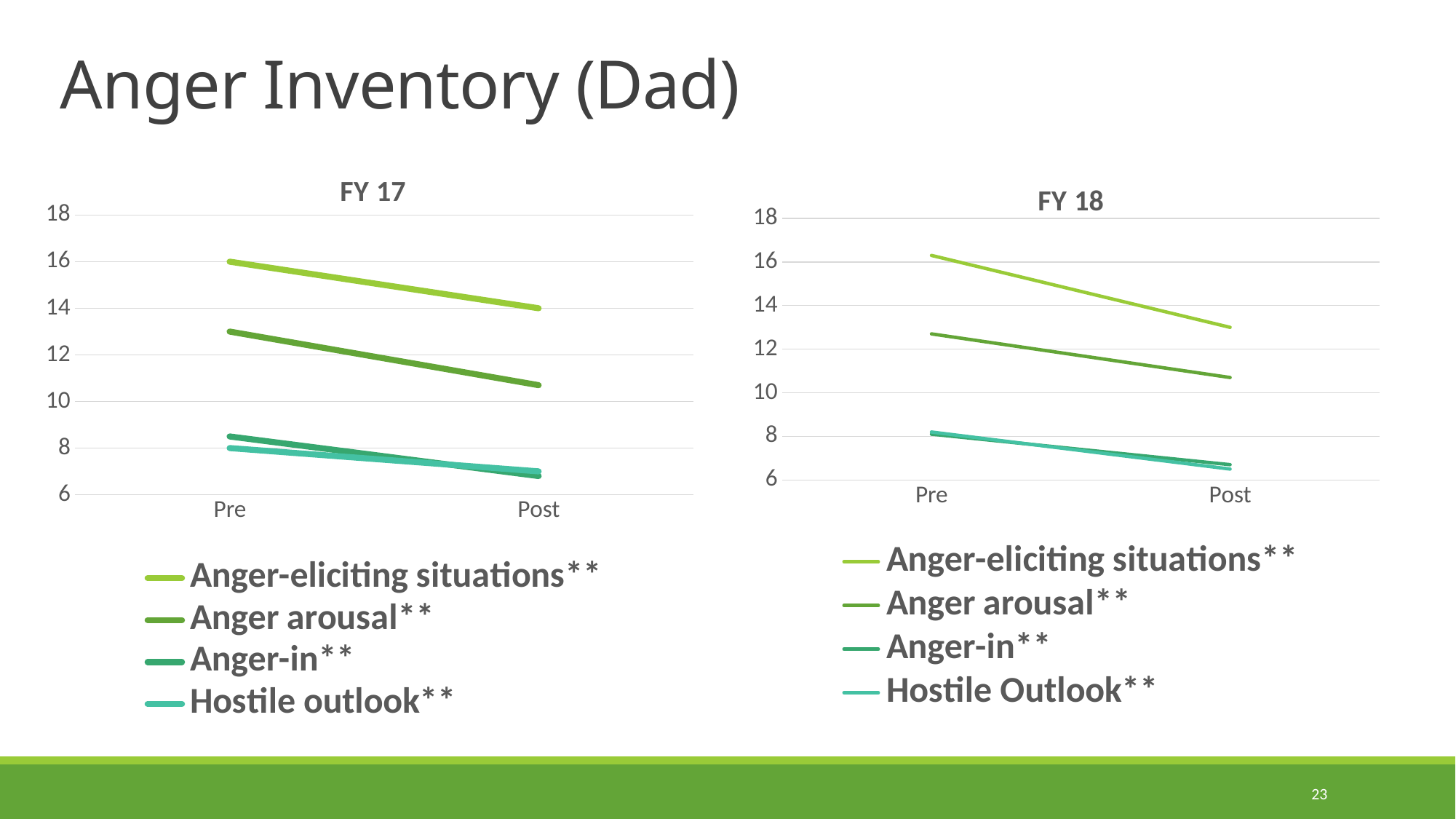
How many series does the legend of the FY 17 chart list? 4 In the FY 17 chart, what is the Post value for Anger-eliciting situations**? 14 What is the title of the chart on the right of the slide? FY 18 How many points are on the x axis of the FY 18 chart? 2 What kind of chart is the FY 17 chart? line chart In the FY 18 chart, which is larger at Post: Anger-eliciting situations** or Anger arousal**? Anger-eliciting situations** In the FY 17 chart, does the Anger-eliciting situations** line rise or fall from Pre to Post? fall In the FY 17 chart, is the Pre value for Anger arousal** greater or less than 12? greater In the FY 17 chart, what is the Pre value for Anger-eliciting situations**? 16 In the FY 18 chart, is the Pre value for Anger-eliciting situations** greater or less than 14? greater In the FY 18 chart, which series has the highest value at Pre? Anger-eliciting situations** In the FY 18 chart, is the Post value for Anger arousal** greater or less than 12? less